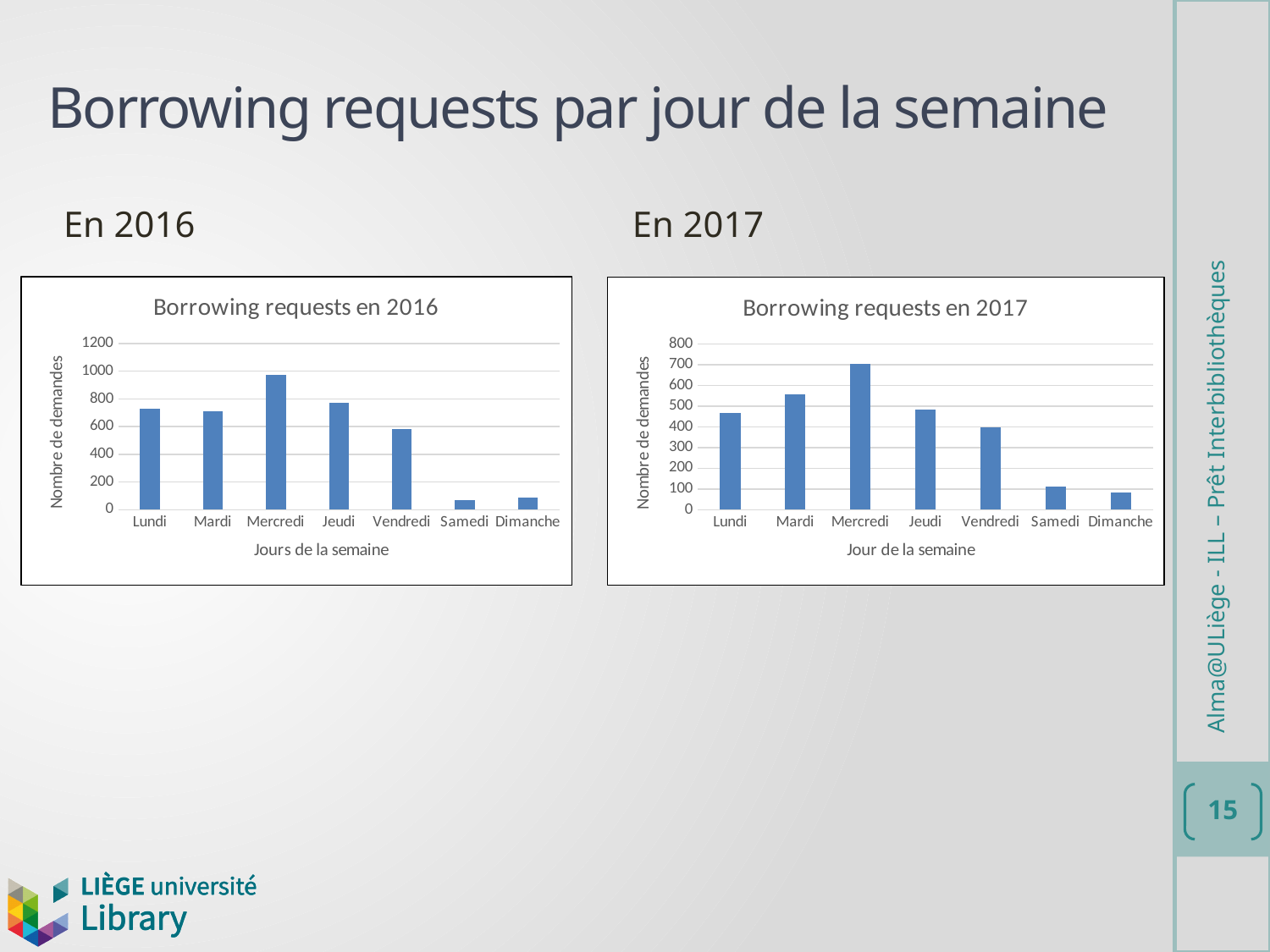
How many days are shown on the x axis of the 'Borrowing requests en 2017' chart? 7 What is the y-axis label of the 'Borrowing requests en 2016' chart? Nombre de demandes In the 'Borrowing requests en 2016' chart, is the value for Mercredi greater or less than 800? greater What kind of chart is 'Borrowing requests en 2016'? Bar chart In the 'Borrowing requests en 2017' chart, which day has the highest number of requests? Mercredi What is the x-axis label of the 'Borrowing requests en 2017' chart? Jour de la semaine In the 'Borrowing requests en 2016' chart, which is larger, the value for Jeudi or the value for Samedi? Jeudi In the 'Borrowing requests en 2017' chart, is the value for Lundi greater or less than 400? greater In the 'Borrowing requests en 2017' chart, which is larger, the value for Mardi or the value for Vendredi? Mardi In the 'Borrowing requests en 2016' chart, which day has the highest number of requests? Mercredi In the 'Borrowing requests en 2017' chart, is the value for Samedi greater or less than 200? less